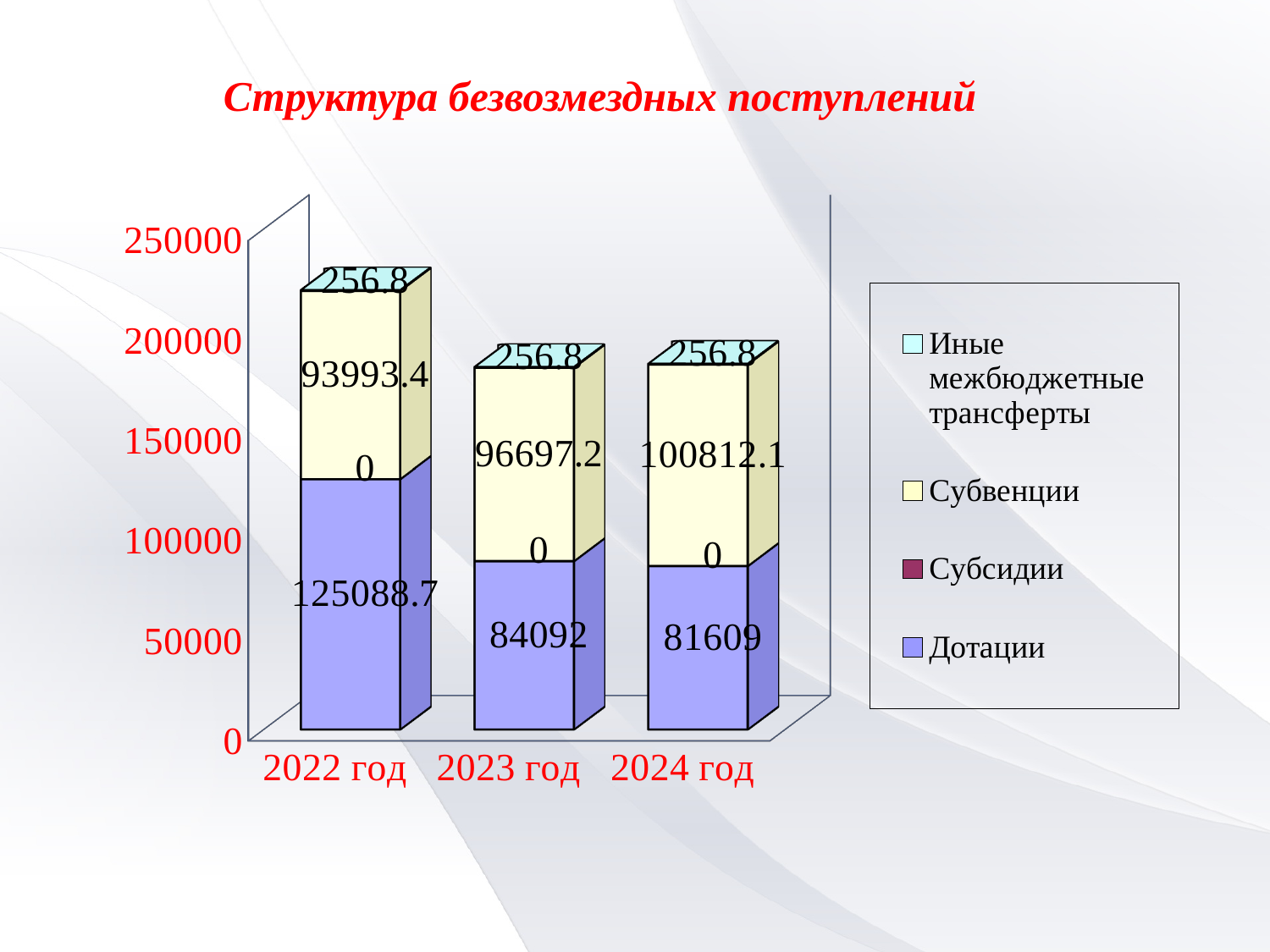
What is the difference between the Дотации values for 2022 год and 2023 год? 40996.7 How many years are shown on the x axis? 3 How many series does the legend list? 4 What is the total of the stacked bar for 2023 год? 181046 What is the value of Субвенции for 2024 год? 100812.1 In which year is the value of Субвенции lowest? 2022 год Which is larger for 2023 год: Дотации or Субвенции? Субвенции What kind of chart is shown on the slide? Stacked bar chart What is the value of Иные межбюджетные трансферты for 2023 год? 256.8 What is the value of Дотации for 2022 год? 125088.7 In which year is the value of Дотации highest? 2022 год What is the value of Субсидии for 2022 год? 0